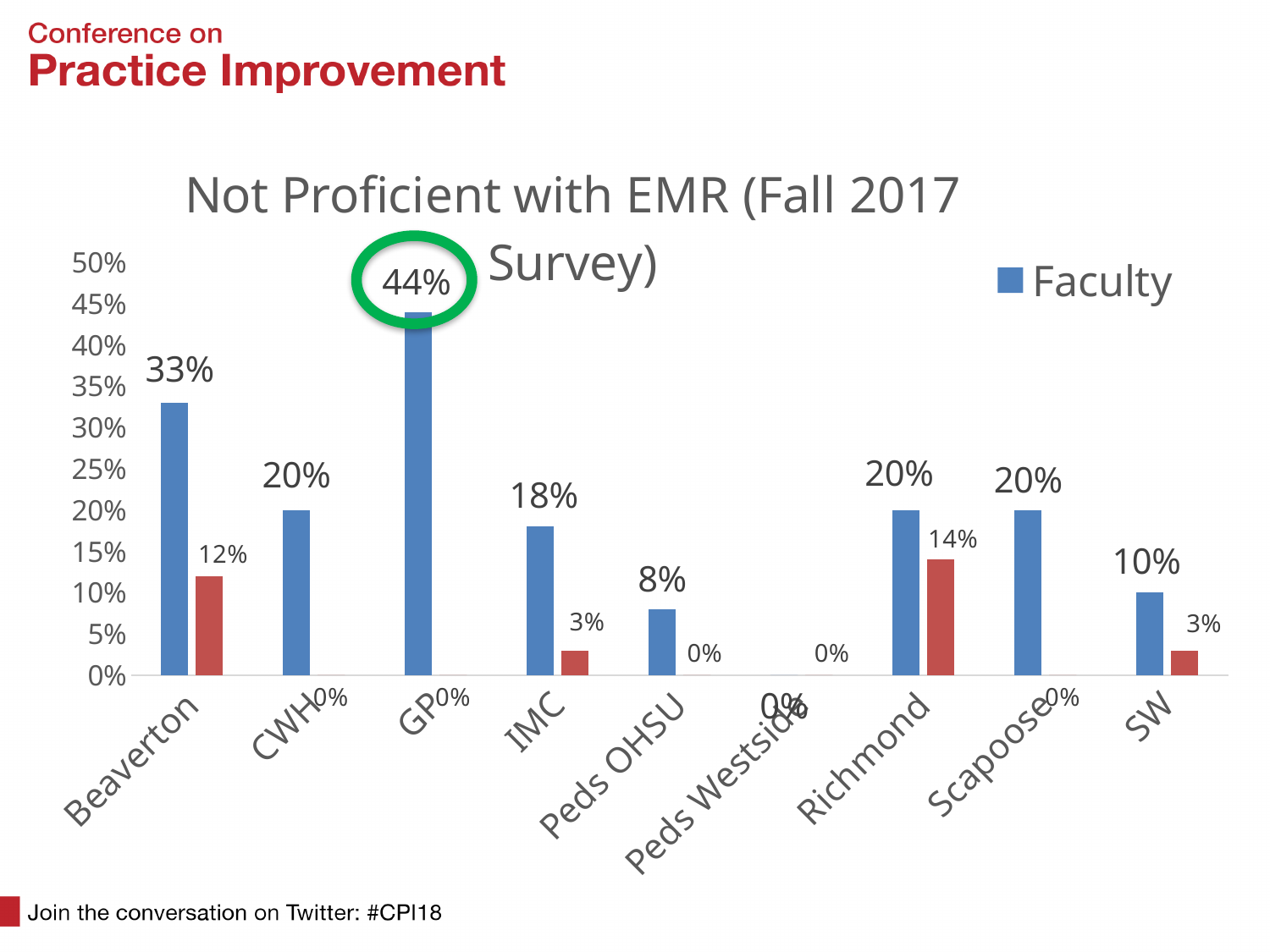
What is the difference between the Faculty values for Beaverton and IMC? 15 percentage points What is the Faculty value for SW? 10% What is the value of the red bar for Richmond? 14% Which category has the highest Faculty value? GP What is the Faculty value for Peds OHSU? 8% What is the title of the chart? Not Proficient with EMR (Fall 2017 Survey) Is the Faculty value for GP greater or less than 40%? greater How many categories are shown on the x axis? 9 What kind of chart is shown? bar chart Which has a larger Faculty value, Beaverton or Richmond? Beaverton What is the Faculty value for GP? 44% What is the Faculty value for Beaverton? 33%